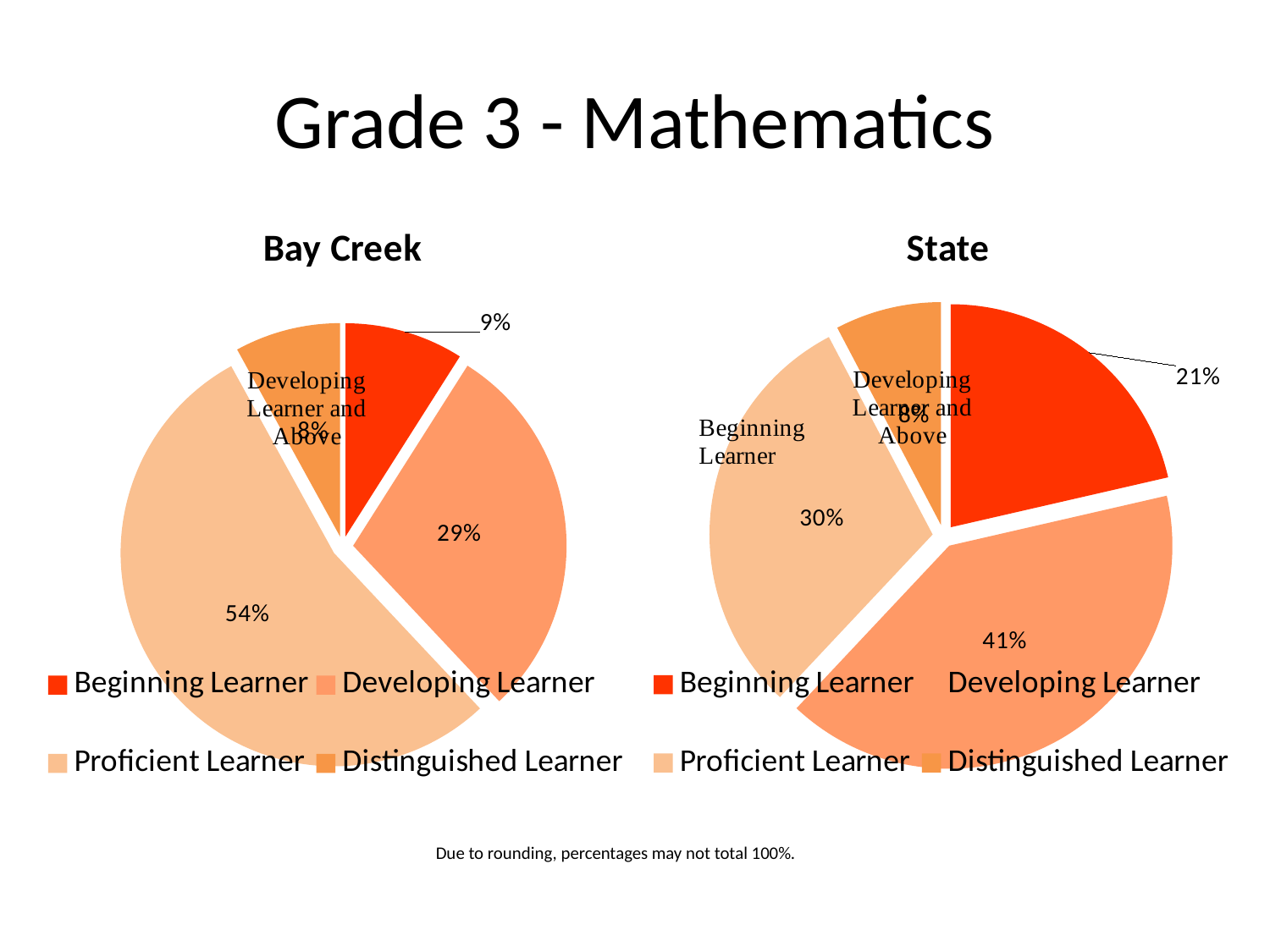
What is the difference between the Proficient Learner percentage in the Bay Creek chart and the Proficient Learner percentage in the State chart? 24% In the Bay Creek chart, which category has the largest slice? Proficient Learner Which is larger: Developing Learner in the Bay Creek chart or Developing Learner in the State chart? State In the Bay Creek chart, what percentage is shown for Beginning Learner? 9% In the Bay Creek chart, what percentage is shown for Proficient Learner? 54% In the State chart, what percentage is shown for Developing Learner? 41% What kind of chart is the State chart? Pie chart How many slices does the Bay Creek pie chart have? 4 How many entries does the legend of the State chart list? 4 In the State chart, what percentage is shown for Beginning Learner? 21% What is the title of the chart on the left side of the slide? Bay Creek In the State chart, which category has the smallest slice? Distinguished Learner